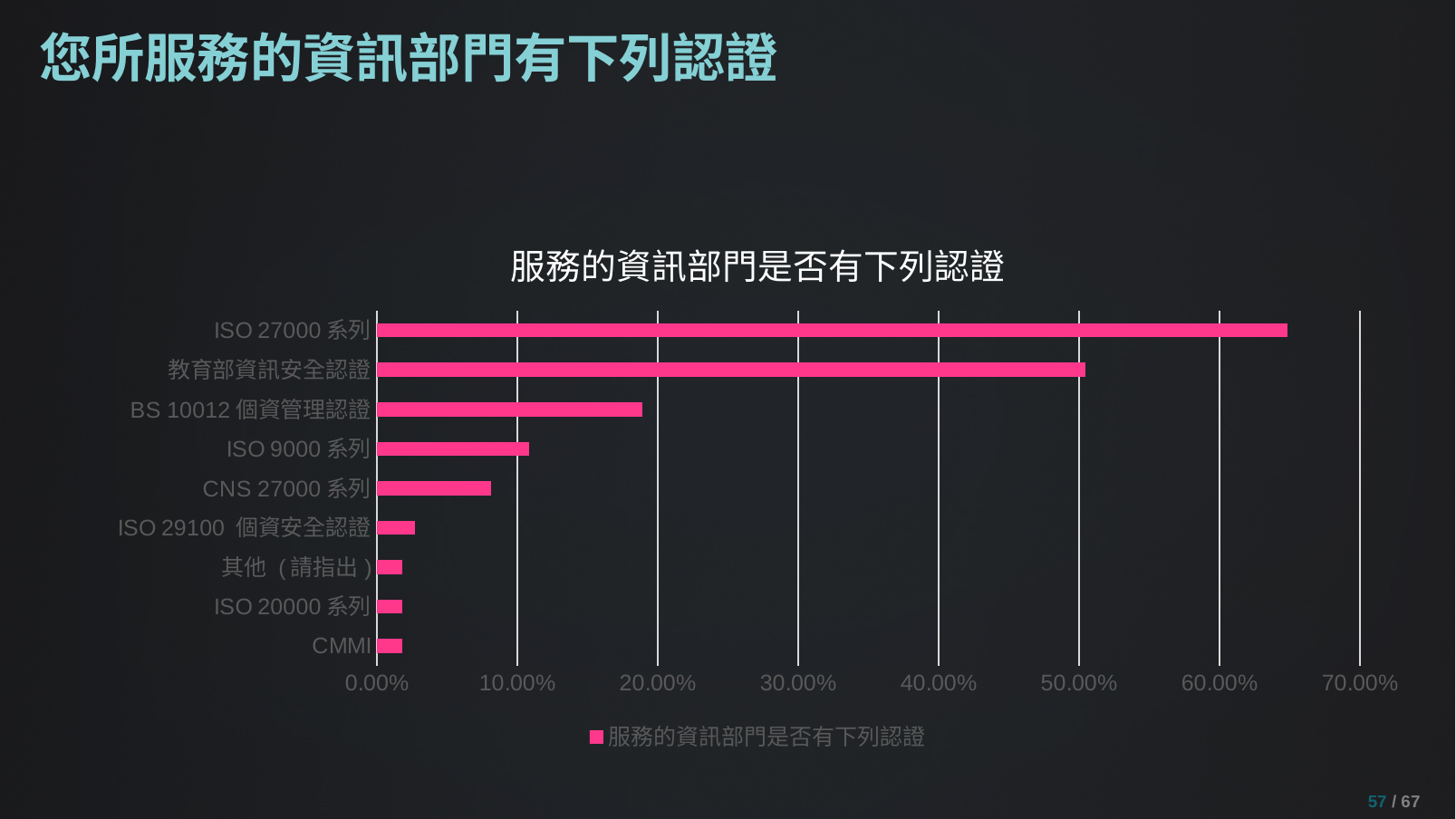
Is the value for 教育部資訊安全認證 greater or less than 40.00%? greater How many certification categories are plotted in the chart? 9 Which is larger, the value for ISO 27000 系列 or the value for 教育部資訊安全認證? ISO 27000 系列 Is the value for ISO 27000 系列 greater or less than 60.00%? greater What is the title of the chart? 服務的資訊部門是否有下列認證 Is the value for ISO 9000 系列 greater or less than 10.00%? greater What kind of chart is shown on the slide? Bar chart Which category has the highest value in the chart? ISO 27000 系列 Which is larger, the value for BS 10012 個資管理認證 or the value for ISO 9000 系列? BS 10012 個資管理認證 How many series does the legend list? 1